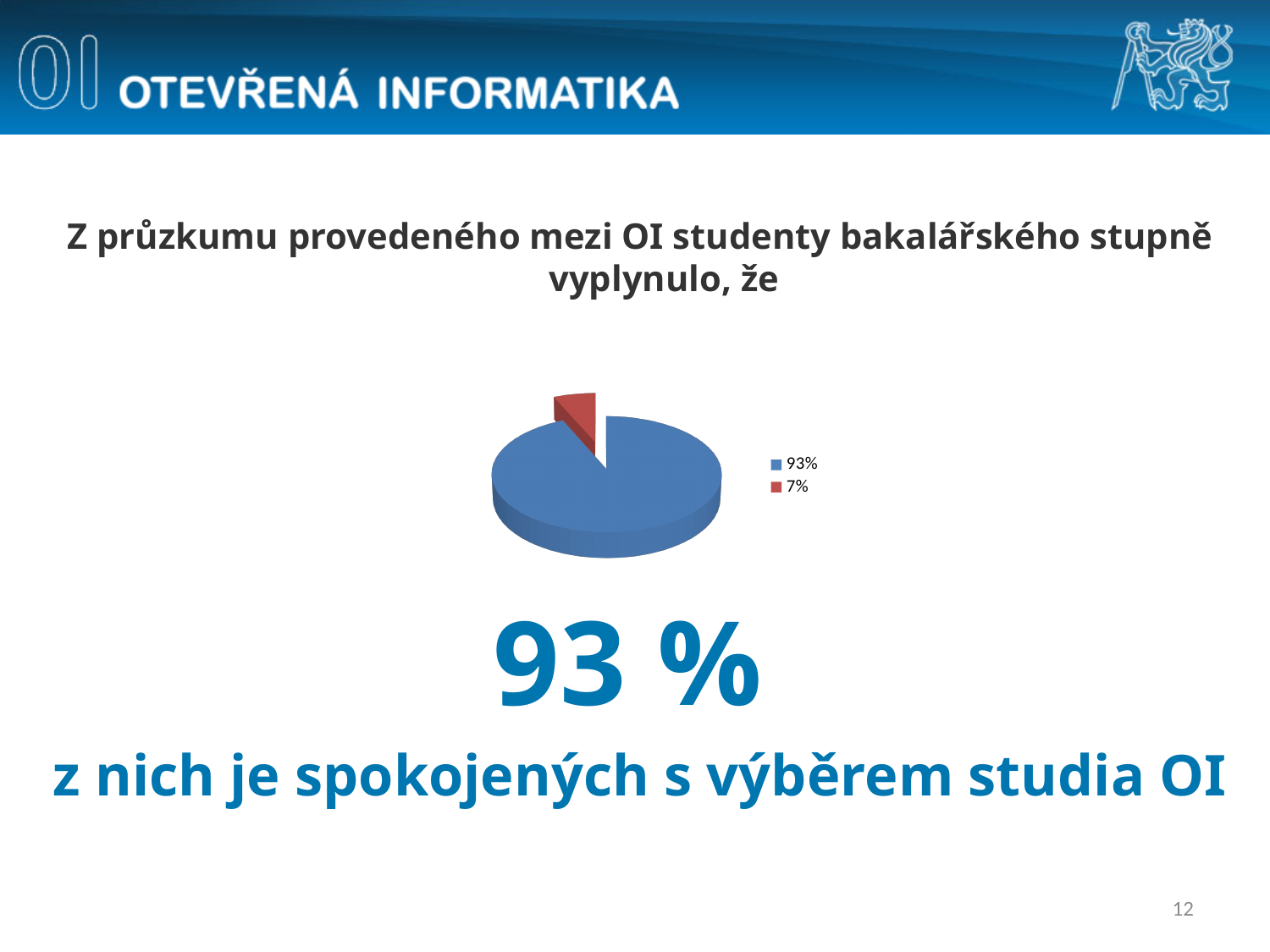
What is the difference in percentage points between the two slices of the pie chart? 86 percentage points How many entries does the legend of the pie chart list? 2 What kind of chart is shown on the slide? pie chart What are the two entries listed in the legend of the pie chart? 93% and 7% What share of the pie does the red slice represent? 7% Is the share of the red slice greater or less than 10%? less Which slice of the pie chart is the smallest? the red slice (7%) What share of the pie does the blue slice represent? 93% What colour is the slice that is pulled out from the pie? red Is the blue slice or the red slice larger? the blue slice Which slice of the pie chart is the largest? the blue slice (93%) How many slices does the pie chart have? 2